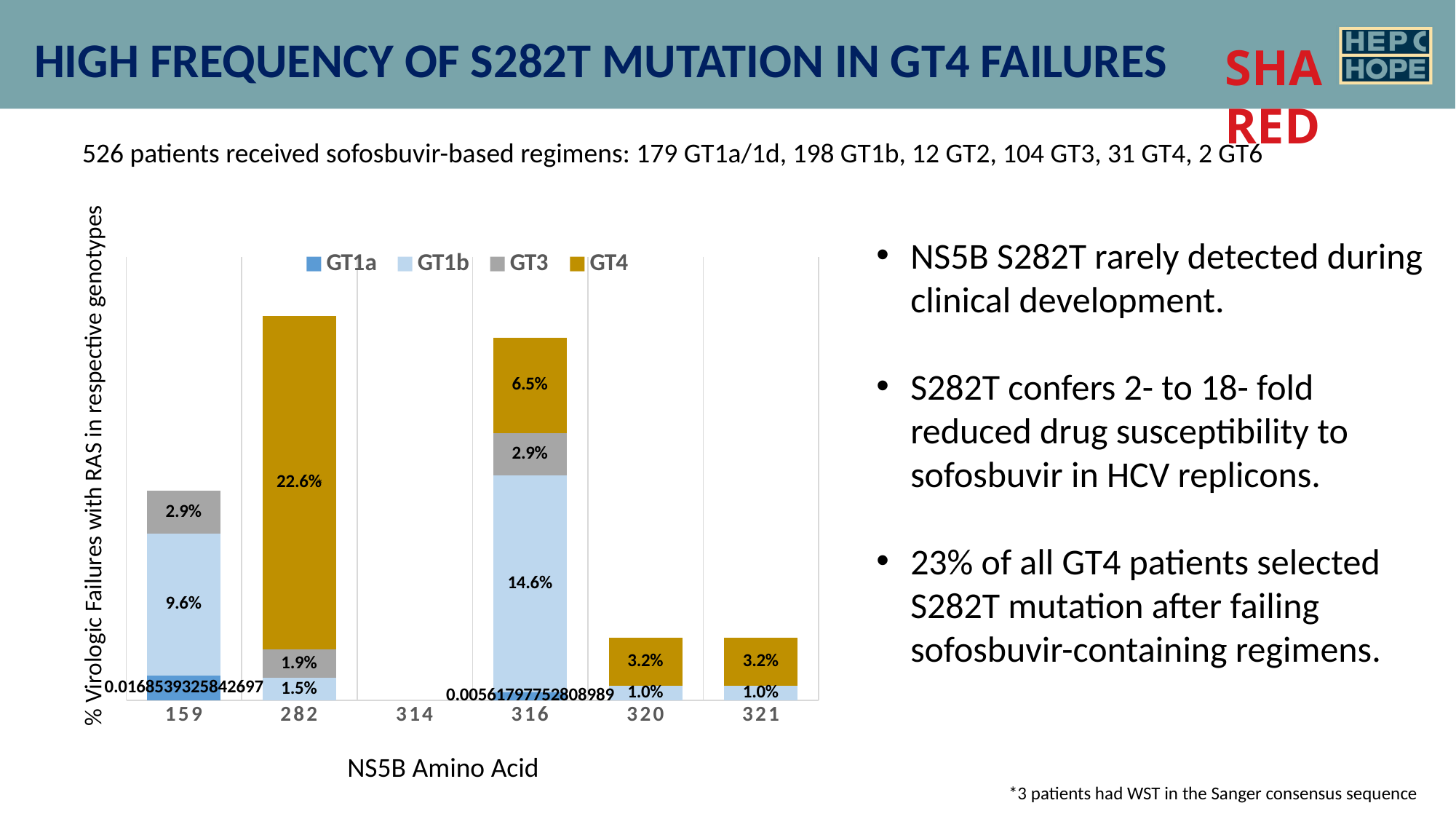
What is the GT3 value at amino acid position 159? 2.9% What is the GT4 value at amino acid position 320? 3.2% What kind of chart is shown on the slide? Stacked bar chart What is the GT1b value at amino acid position 316? 14.6% What is the GT3 value at amino acid position 282? 1.9% At which amino acid position is the GT4 segment the largest? 282 How many amino acid positions are shown on the x axis? 6 What is the difference between the GT4 value at position 282 and the GT4 value at position 316? 16.1% What is the GT4 value at NS5B amino acid position 282? 22.6% What is the total of the stacked bar at amino acid position 320? 4.2% How many series does the legend list? 4 Which is larger, the GT1b value at position 159 or at position 316? 316